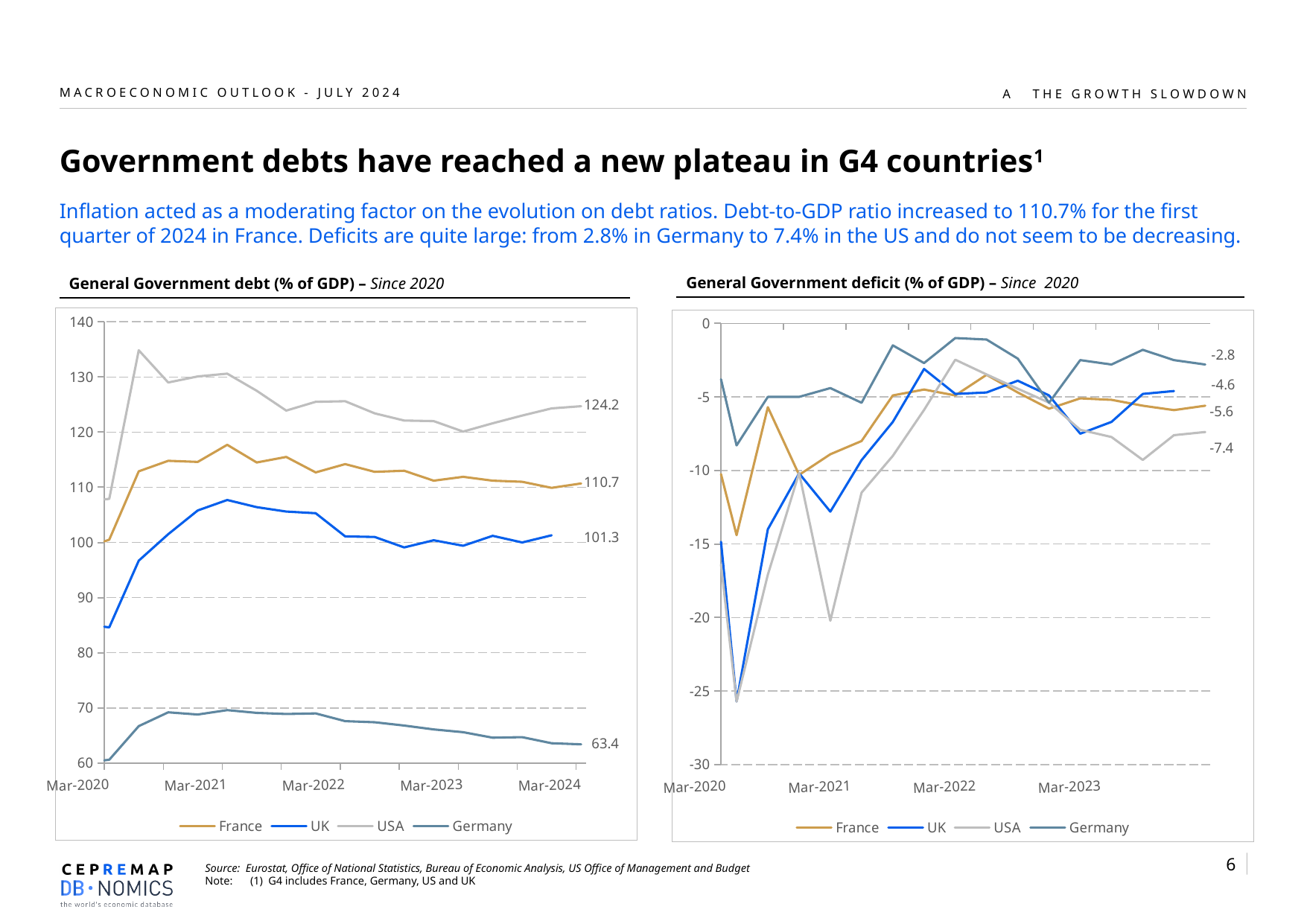
In the General Government debt chart, how many series does the legend list? 4 In the General Government deficit chart, which is larger at the end of the series, the UK value or the France value? UK In the General Government debt chart, what is the latest value shown for Germany? 63.4 In the General Government deficit chart, what is the latest value shown for the USA? -7.4 In the General Government debt chart, which country has the lowest debt ratio at the end of the series? Germany What kind of chart is the General Government deficit chart? Line chart In the General Government debt chart, what is the latest value shown for the USA? 124.2 In the General Government debt chart, is the value for Germany at Mar-2024 greater or less than 70? less In the General Government debt chart, what is the difference between the latest values for the USA and the UK? 22.9 In the General Government deficit chart, what is the latest value shown for Germany? -2.8 In the General Government debt chart, what is the latest value shown for France? 110.7 In the General Government debt chart, does the Germany line rise or fall from Mar-2022 to Mar-2024? Fall